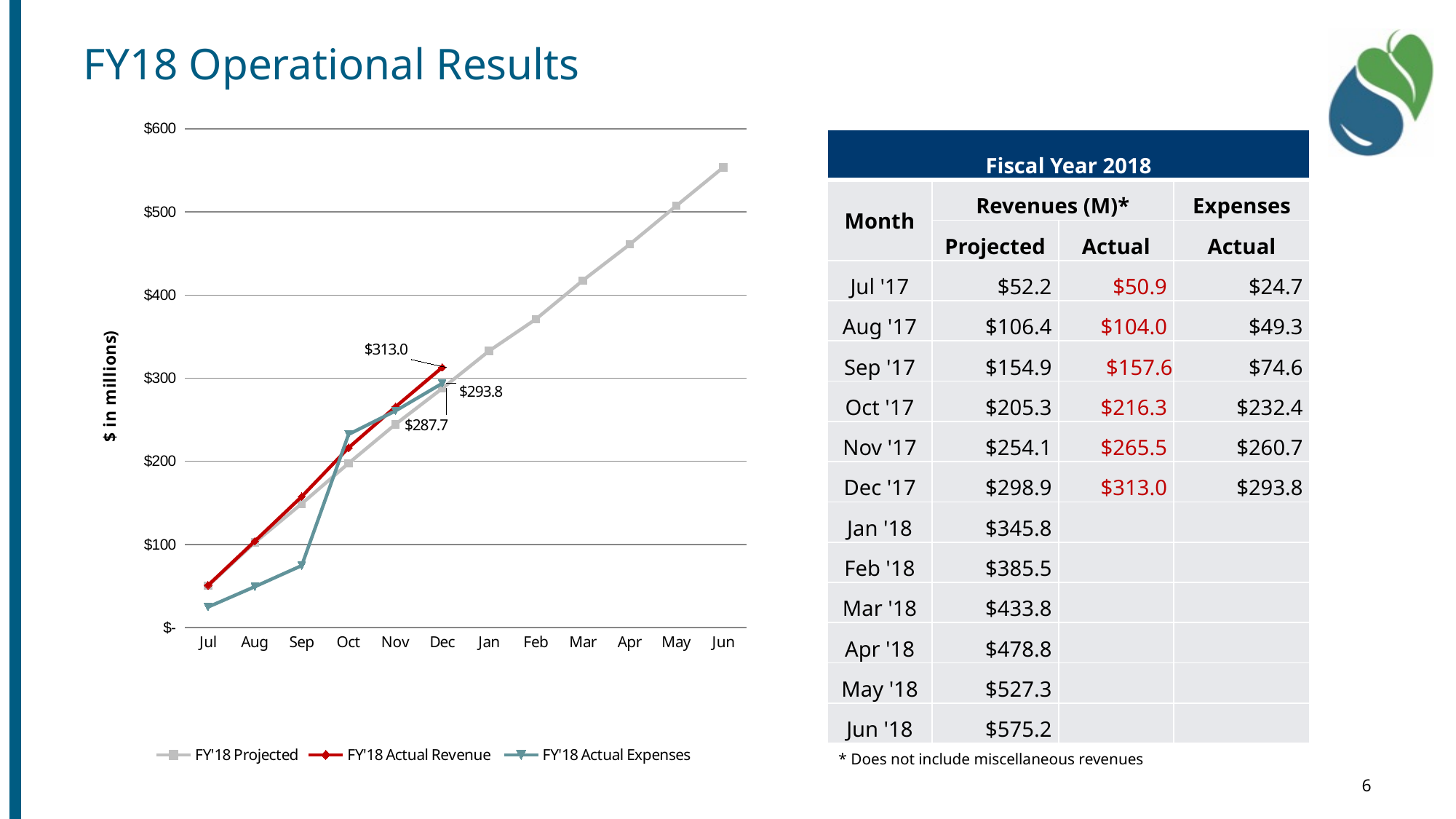
What type of chart is shown on the slide? line chart What is the labelled value for FY'18 Actual Revenue in Dec on the chart? $313.0 In Dec, which is larger on the chart: FY'18 Actual Revenue or FY'18 Actual Expenses? FY'18 Actual Revenue What is the labelled value for FY'18 Actual Expenses in Dec on the chart? $293.8 Is the FY'18 Projected value for Jun greater or less than $500? greater What is the label on the y axis of the chart? $ in millions What is the difference between the Dec FY'18 Actual Revenue and the Dec FY'18 Actual Expenses labelled on the chart? $19.2 How many months are shown along the x axis of the chart? 12 Is the FY'18 Actual Expenses value for Oct greater or less than $200? greater How many series does the chart legend list? 3 Does the FY'18 Projected line rise or fall from Jul to Jun? rise Is the FY'18 Actual Expenses value for Jul greater or less than $100? less